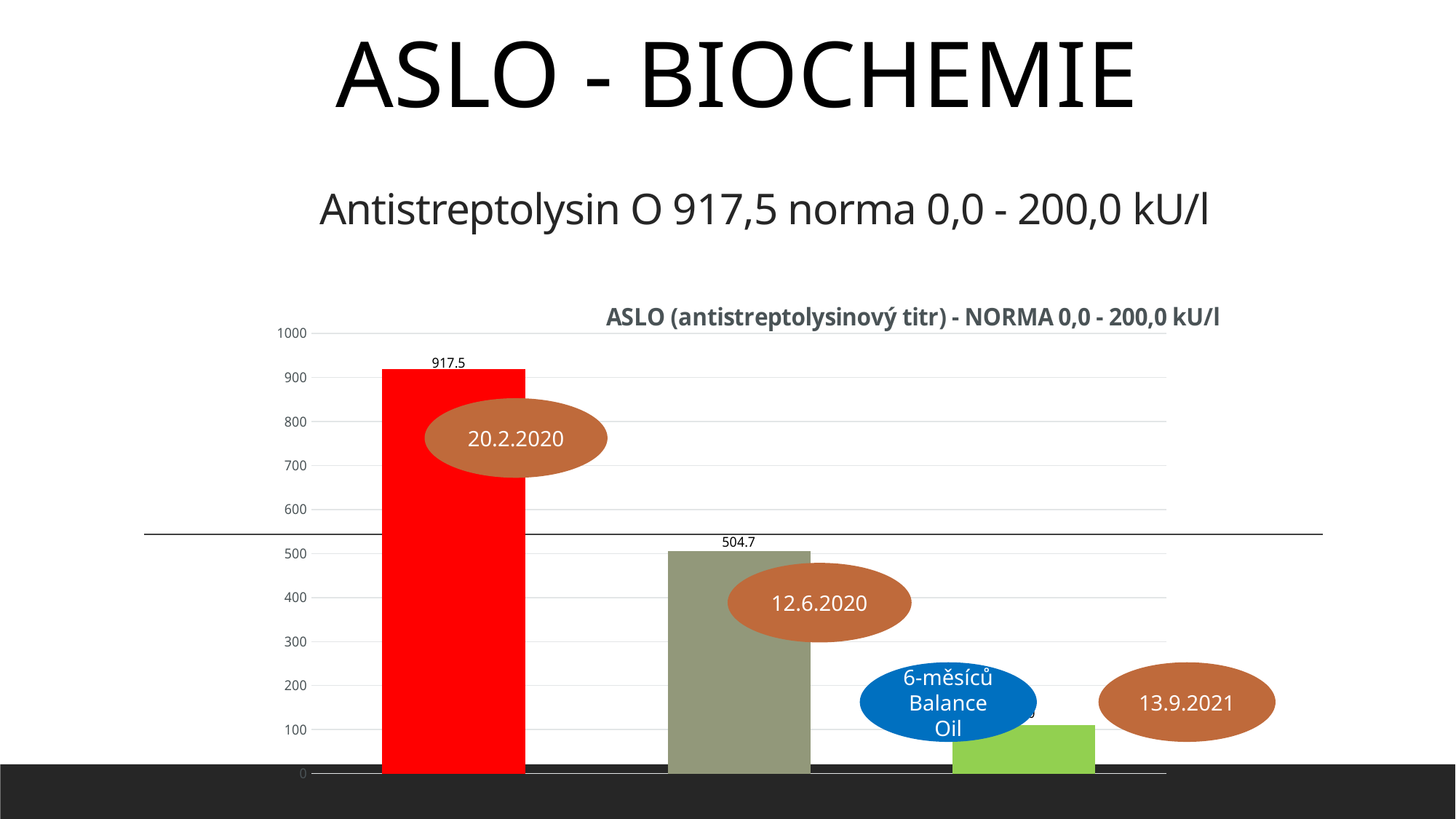
How many bars are plotted in the chart? 3 What is the difference between the red bar (917.5) and the grey-green bar (504.7)? 412.8 What kind of chart is shown on the slide? bar chart What is the value of the grey-green bar (annotated 12.6.2020)? 504.7 Which bar has the lowest value? the green bar (13.9.2021) Which is larger, the red bar (20.2.2020) or the grey-green bar (12.6.2020)? the red bar (20.2.2020) What is the value of the red bar (annotated 20.2.2020)? 917.5 What is the highest value shown on the vertical axis? 1000 Is the value of the green bar (13.9.2021) greater or less than 200? less Do the bar values rise or fall from left to right? fall What is the title of the chart? ASLO (antistreptolysinový titr) - NORMA 0,0 - 200,0 kU/l Which bar has the highest value? the red bar (20.2.2020)